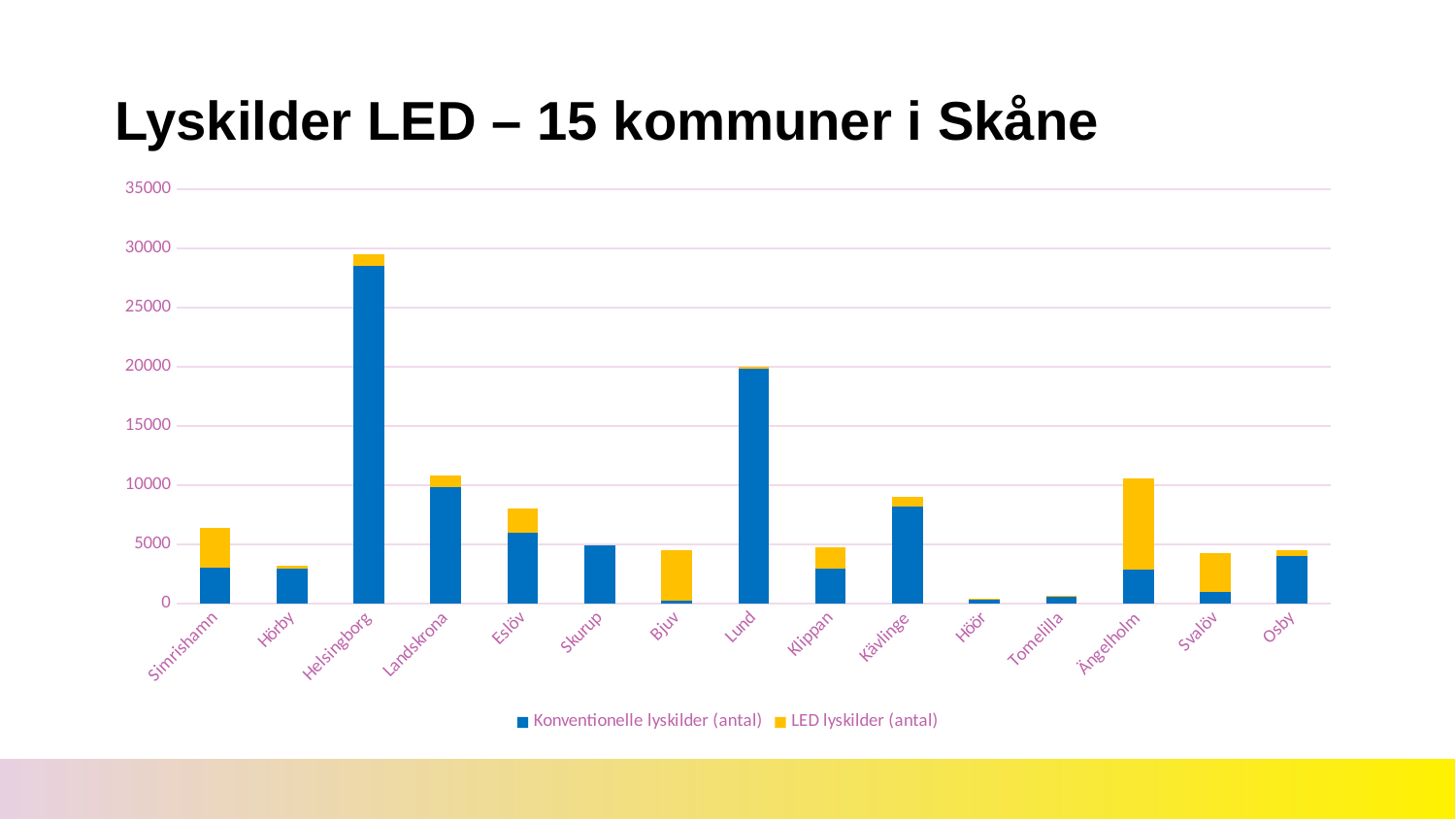
What is the title of the slide? Lyskilder LED – 15 kommuner i Skåne Which has a larger total bar, Lund or Kävlinge? Lund How many municipalities (categories) are shown on the x axis? 15 What kind of chart is shown on the slide? Stacked bar chart Which colour represents LED lyskilder (antal) in the chart? Yellow Which municipality has the highest total bar? Helsingborg Is the total value for Lund greater or less than 15000? greater Is the total value for Helsingborg greater or less than 25000? greater Is the total value for Höör greater or less than 5000? less How many series does the legend list? 2 Which municipality has the tallest LED lyskilder (antal) segment? Ängelholm